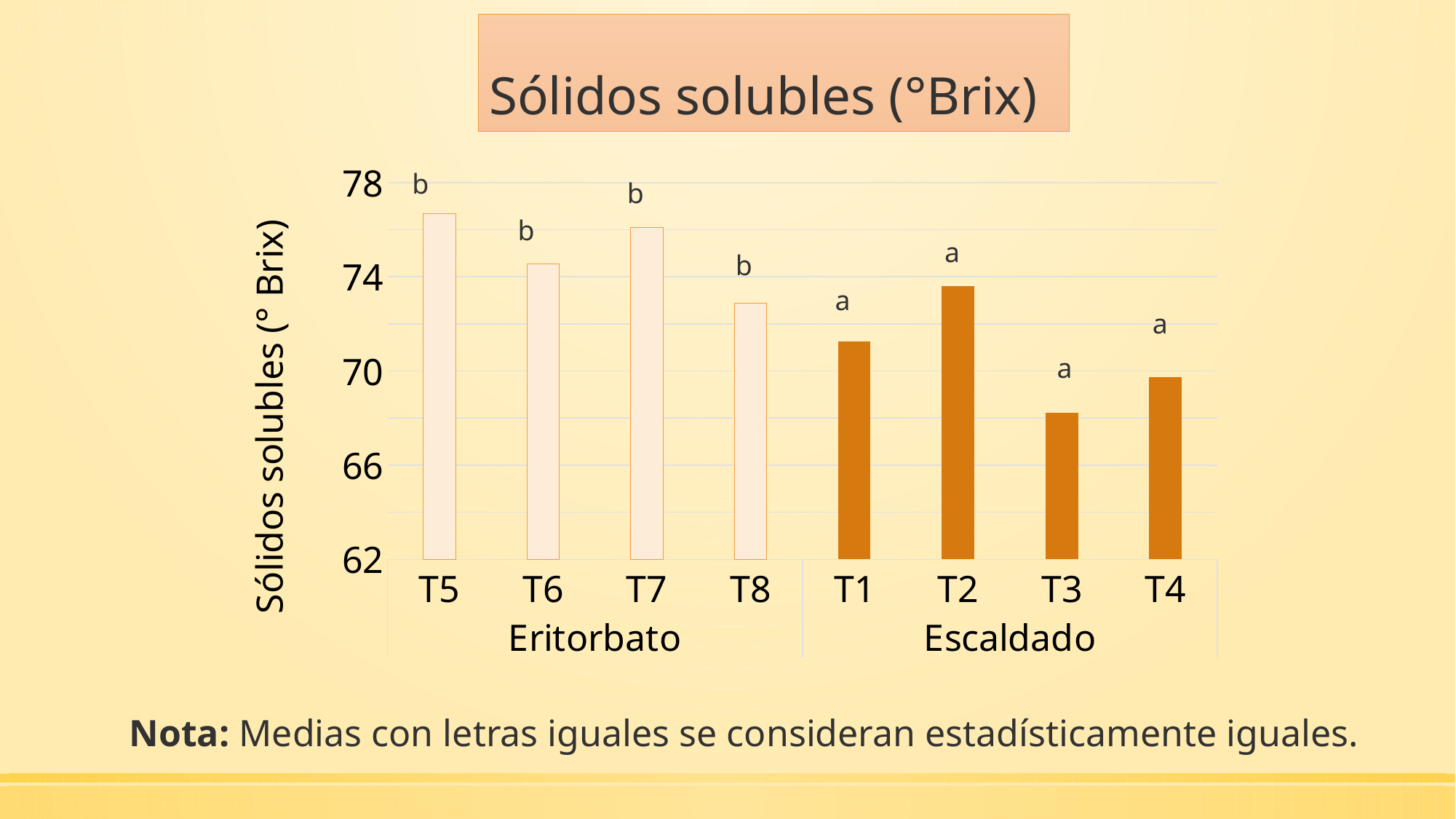
Is the value for T1 greater or less than 70? greater Which treatment has the lowest soluble solids value? T3 What kind of chart is shown on the slide? bar chart Which has a higher soluble solids value, T1 or T2? T2 Which treatment group is shown with the darker orange bars? Escaldado Is the value for T8 greater or less than 74? less How many bars (treatments) are plotted in the chart? 8 Which treatment has the highest soluble solids value? T5 Which has a higher soluble solids value, T6 or T8? T6 Is the value for T5 greater or less than 74? greater What is the title of the chart? Sólidos solubles (°Brix)